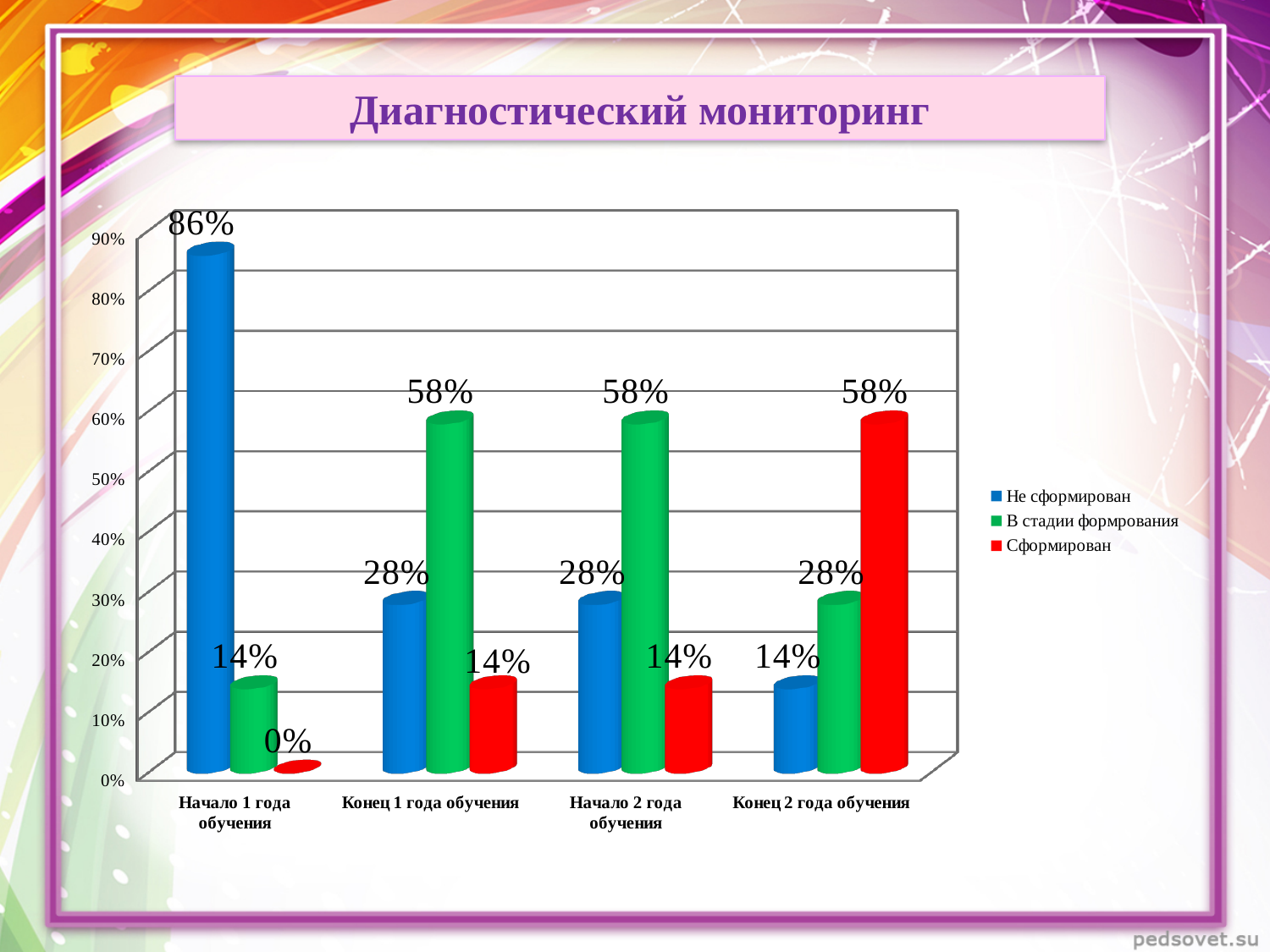
How many series does the legend list? 3 Does the value for "Сформирован" rise or fall from "Начало 1 года обучения" to "Конец 2 года обучения"? Rise What is the value for "Не сформирован" at "Начало 1 года обучения"? 86% Which is larger at "Конец 2 года обучения": "Не сформирован" or "Сформирован"? Сформирован What is the difference between the "Не сформирован" values at "Начало 1 года обучения" and "Конец 2 года обучения"? 72% Which category has the lowest value for "Сформирован"? Начало 1 года обучения What kind of chart is shown on the slide? Bar chart Which category has the highest value for "Не сформирован"? Начало 1 года обучения What is the value for "В стадии формрования" at "Конец 1 года обучения"? 58% How many categories are shown on the x axis? 4 What is the value for "Сформирован" at "Начало 1 года обучения"? 0% What is the value for "Сформирован" at "Конец 2 года обучения"? 58%